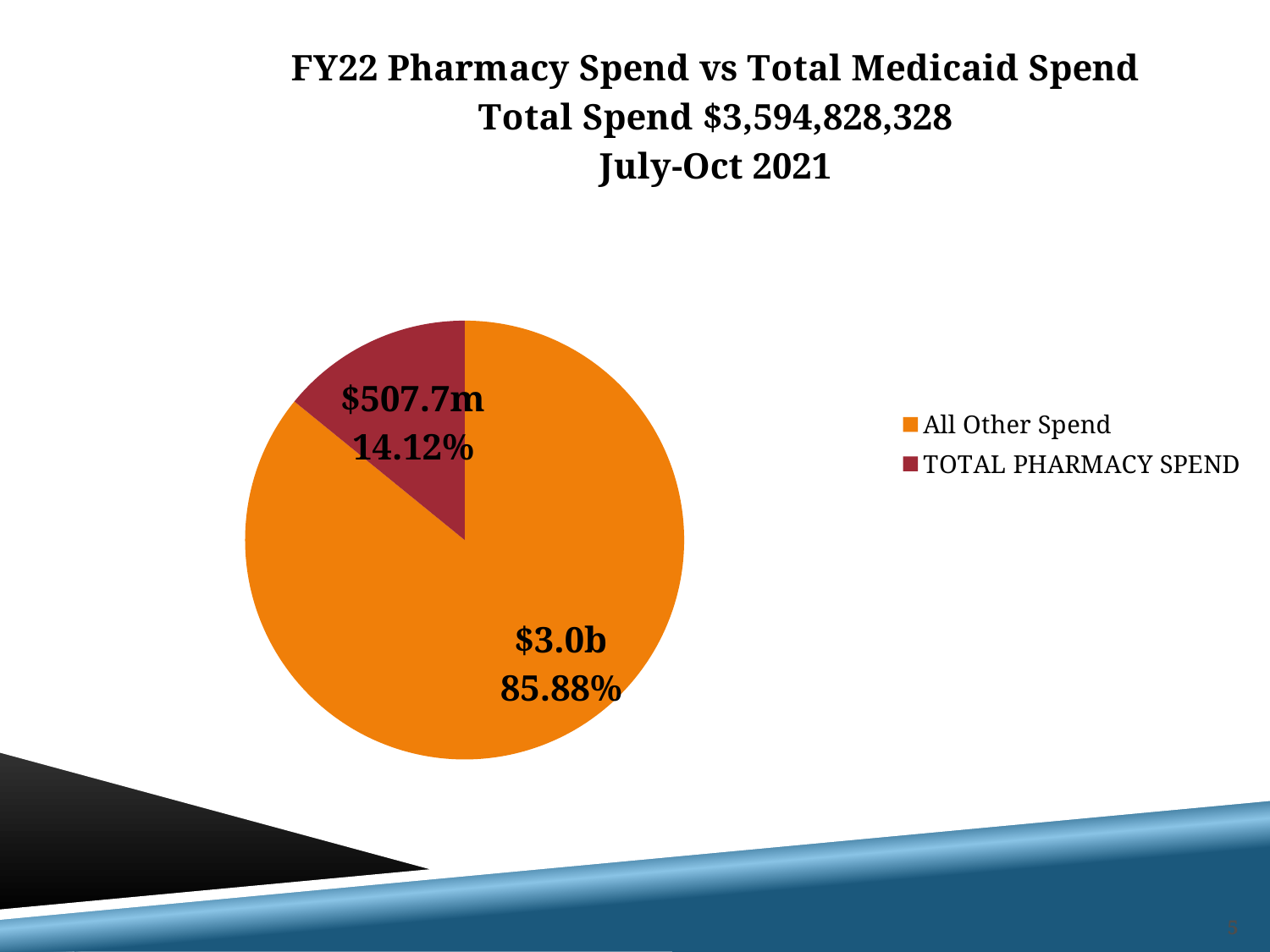
What kind of chart is shown on the slide? pie chart What colour is the TOTAL PHARMACY SPEND slice? dark red What percentage share of the pie is All Other Spend? 85.88% What is the value shown for All Other Spend? $3.0b How many entries does the legend list? 2 Which is larger, All Other Spend or TOTAL PHARMACY SPEND? All Other Spend What is the total spend stated in the chart title? $3,594,828,328 How many slices does the pie chart have? 2 Which slice is the largest? All Other Spend What percentage share of the pie is TOTAL PHARMACY SPEND? 14.12% Which slice is the smallest? TOTAL PHARMACY SPEND What is the value shown for TOTAL PHARMACY SPEND? $507.7m